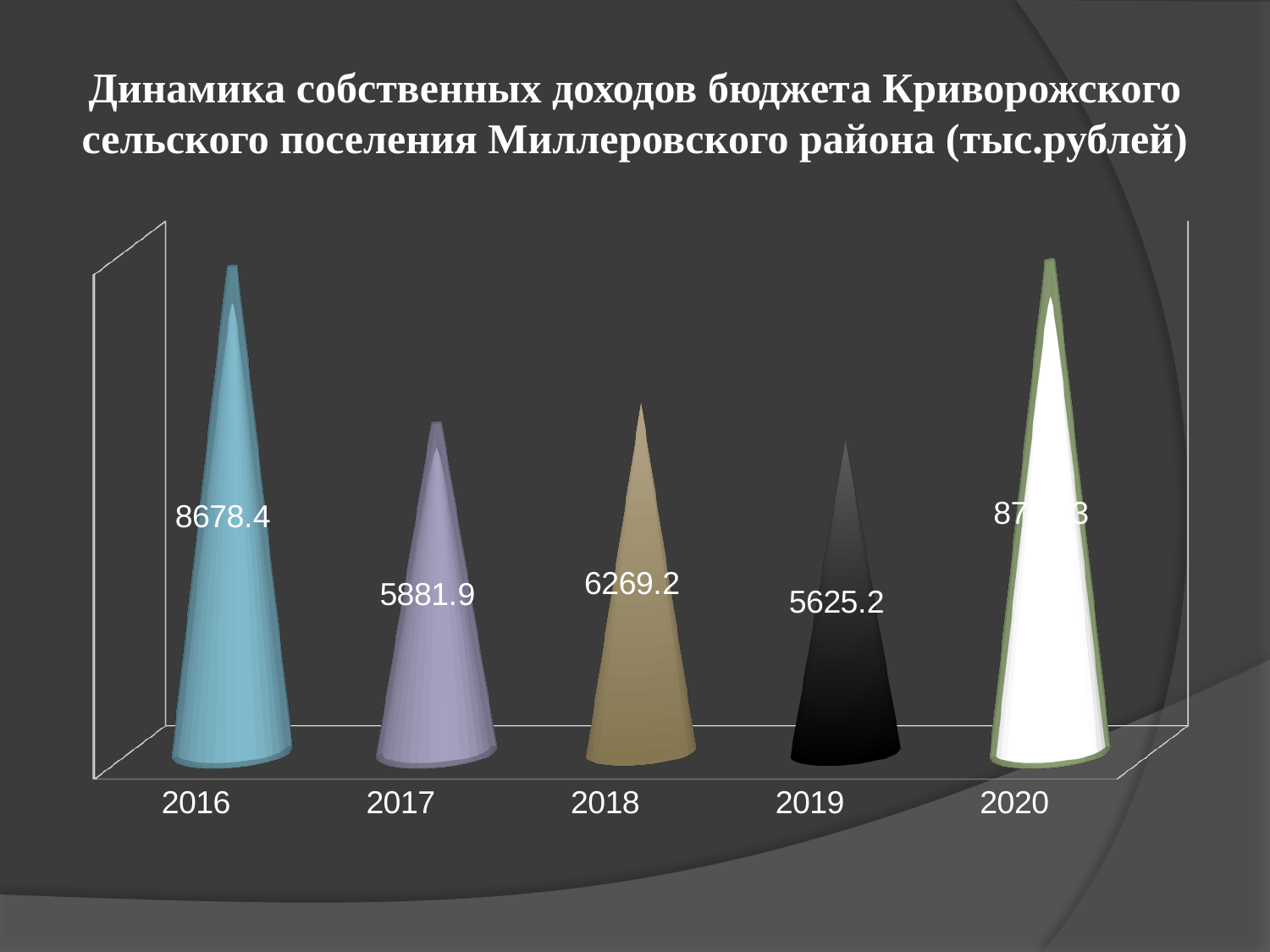
What is the difference between the values for 2018 and 2019? 644.0 What is the difference between the values for 2016 and 2017? 2796.5 In what units are the values given, according to the title? тыс.рублей How many years are shown on the x axis? 5 What is the value for 2018? 6269.2 What is the value for 2016? 8678.4 What is the value for 2017? 5881.9 Which year has the lowest value? 2019 What is the value for 2019? 5625.2 What kind of chart is this? bar chart Does the value rise or fall from 2018 to 2019? fall Which is larger, the value for 2017 or the value for 2018? 2018